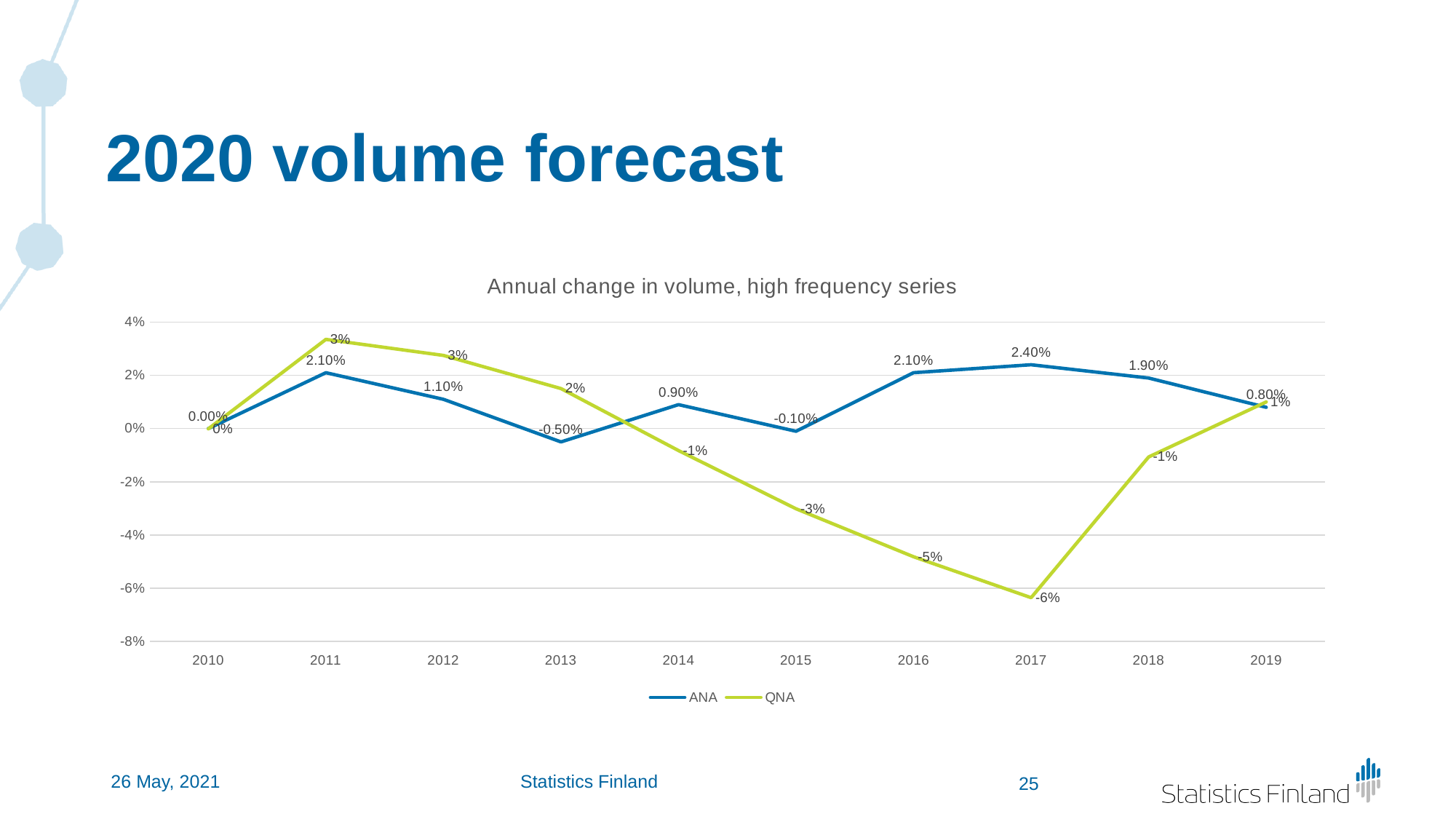
Is the QNA value for 2017 greater or less than -4%? less Does the QNA series rise or fall from 2013 to 2017? fall What kind of chart is shown on the slide? line chart How many years are shown on the x axis? 10 In which year does the QNA series reach its lowest value? 2017 What is the ANA value for 2013? -0.50% In which year does the ANA series reach its highest value? 2017 What is the QNA value for 2016? -5% What is the difference between the ANA values for 2017 and 2018? 0.50% How many series does the legend list? 2 In 2014, which series has the larger value, ANA or QNA? ANA What is the ANA value for 2017? 2.40%